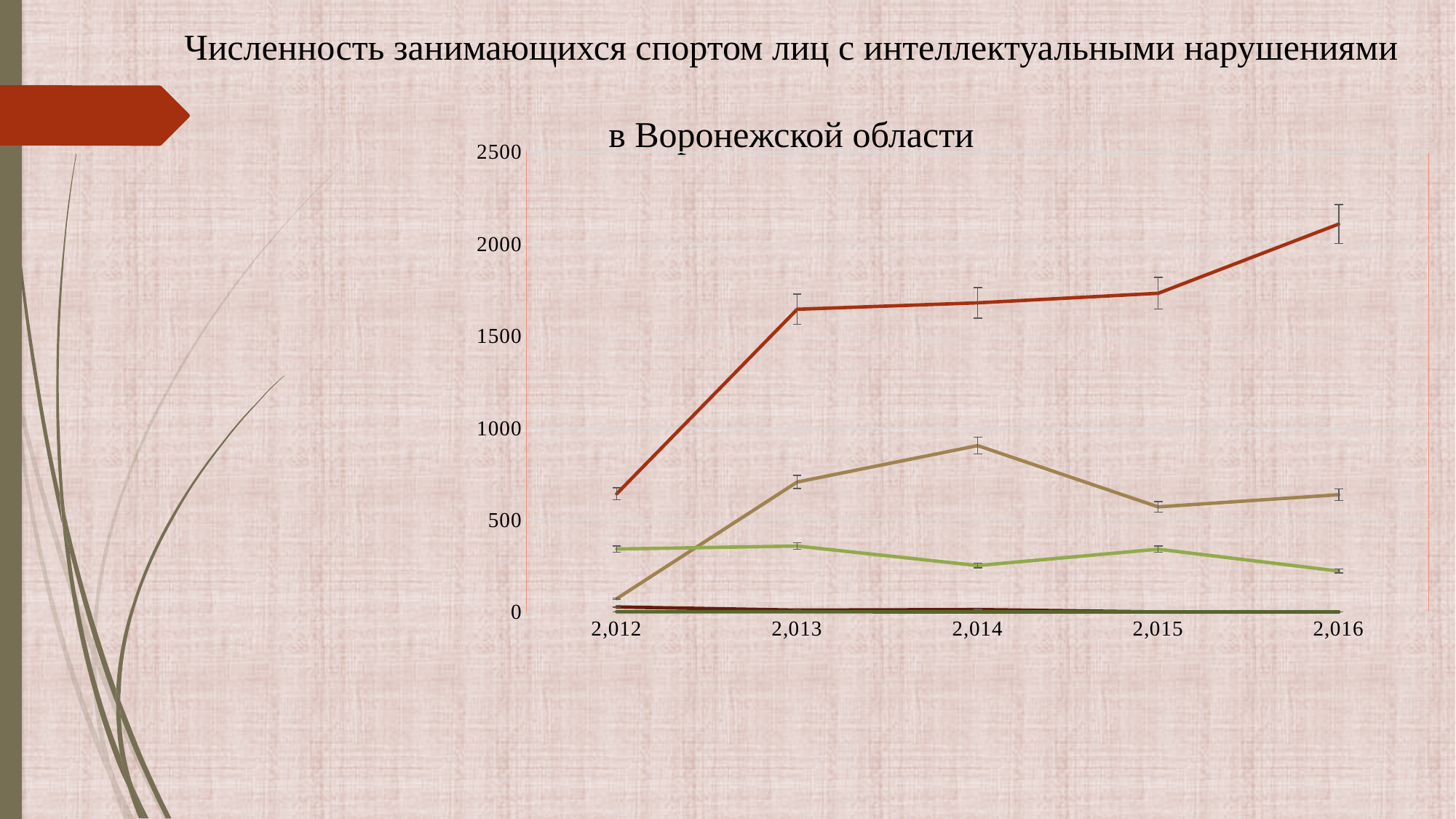
Is the value of the tan (light brown) line in 2,014 greater or less than 1000? less Is the value of the red line in 2,012 greater or less than 1000? less What is the last year shown on the x axis? 2,016 In which year does the tan (light brown) line reach its highest value? 2,014 What is the first year shown on the x axis? 2,012 What kind of chart is shown on the slide? line chart How many years are shown along the x axis of the chart? 5 What is the highest value shown on the y axis of the chart? 2500 Does the red line rise or fall overall from 2,012 to 2,016? rise In which year does the red line reach its highest value? 2,016 Is the value of the red line in 2,016 greater or less than 2000? greater In 2,013, which line has the larger value, the red line or the light green line? the red line